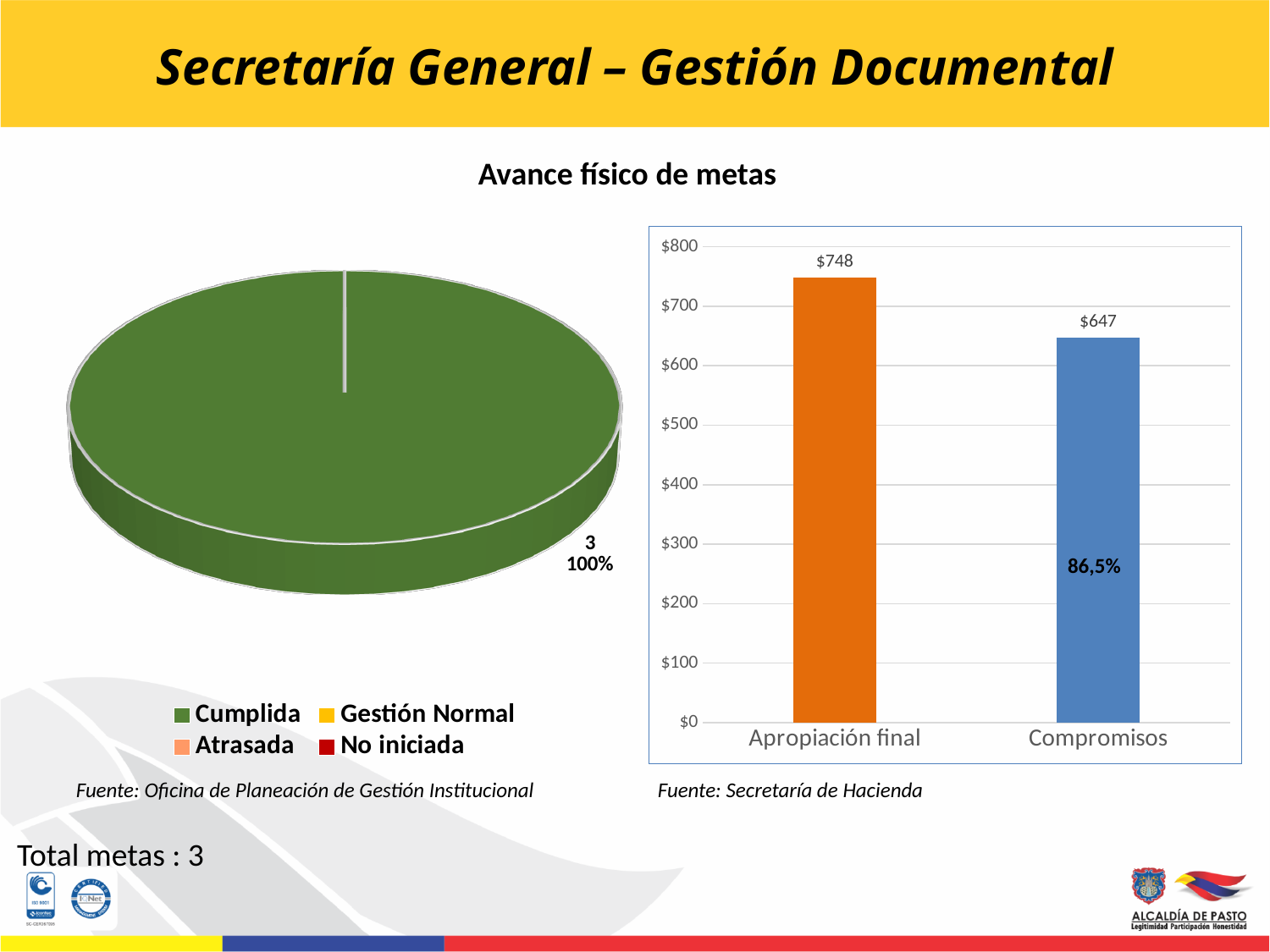
In the bar chart on the right, which category has the higher value? Apropiación final What kind of chart is shown on the left side of the slide? Pie chart In the bar chart on the right, what percentage label is printed on the Compromisos bar? 86,5% In the pie chart on the left, what share does the Cumplida slice represent? 100% In the bar chart on the right, how many categories are shown on the x axis? 2 In the bar chart on the right, what is the difference between Apropiación final and Compromisos? $101 In the pie chart on the left, how many entries does the legend list? 4 In the bar chart on the right, what is the value for Apropiación final? $748 In the bar chart on the right, which category has the lower value? Compromisos In the pie chart on the left, what count is printed next to the Cumplida slice? 3 In the bar chart on the right, what is the value for Compromisos? $647 In the bar chart on the right, is the value for Compromisos greater or less than $600? greater